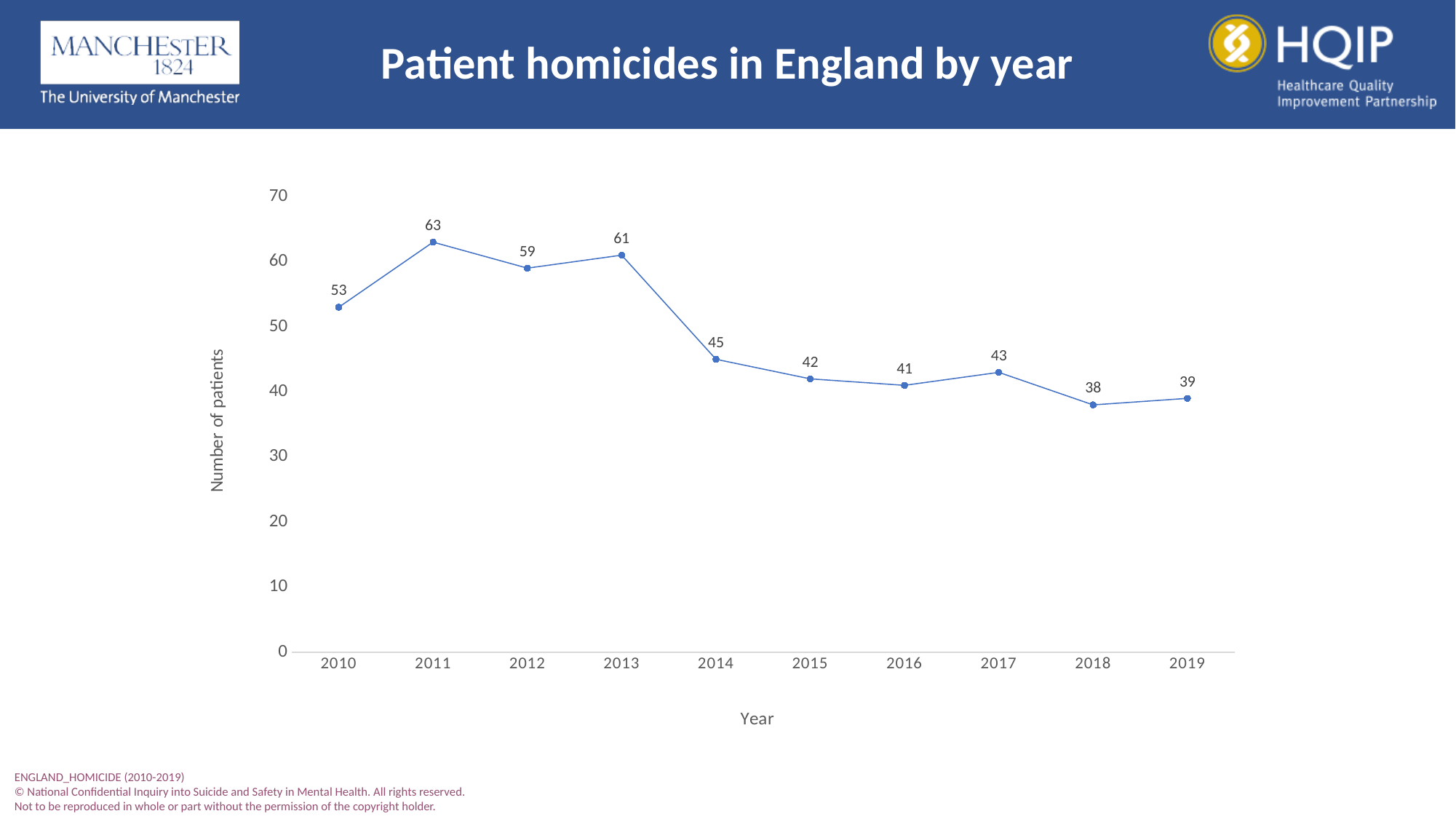
Which year has the lowest number of patients? 2018 What is the difference between the number of patients in 2011 and in 2019? 24 What is the number of patients in 2014? 45 How many years are plotted on the chart? 10 Which year has more patients, 2012 or 2017? 2012 Which year has the highest number of patients? 2011 What kind of chart is shown on the slide? Line chart What is the difference between the number of patients in 2013 and in 2014? 16 What is the number of patients in 2011? 63 What is the label of the y axis? Number of patients Is the value for 2010 greater or less than 50? greater What is the number of patients in 2018? 38